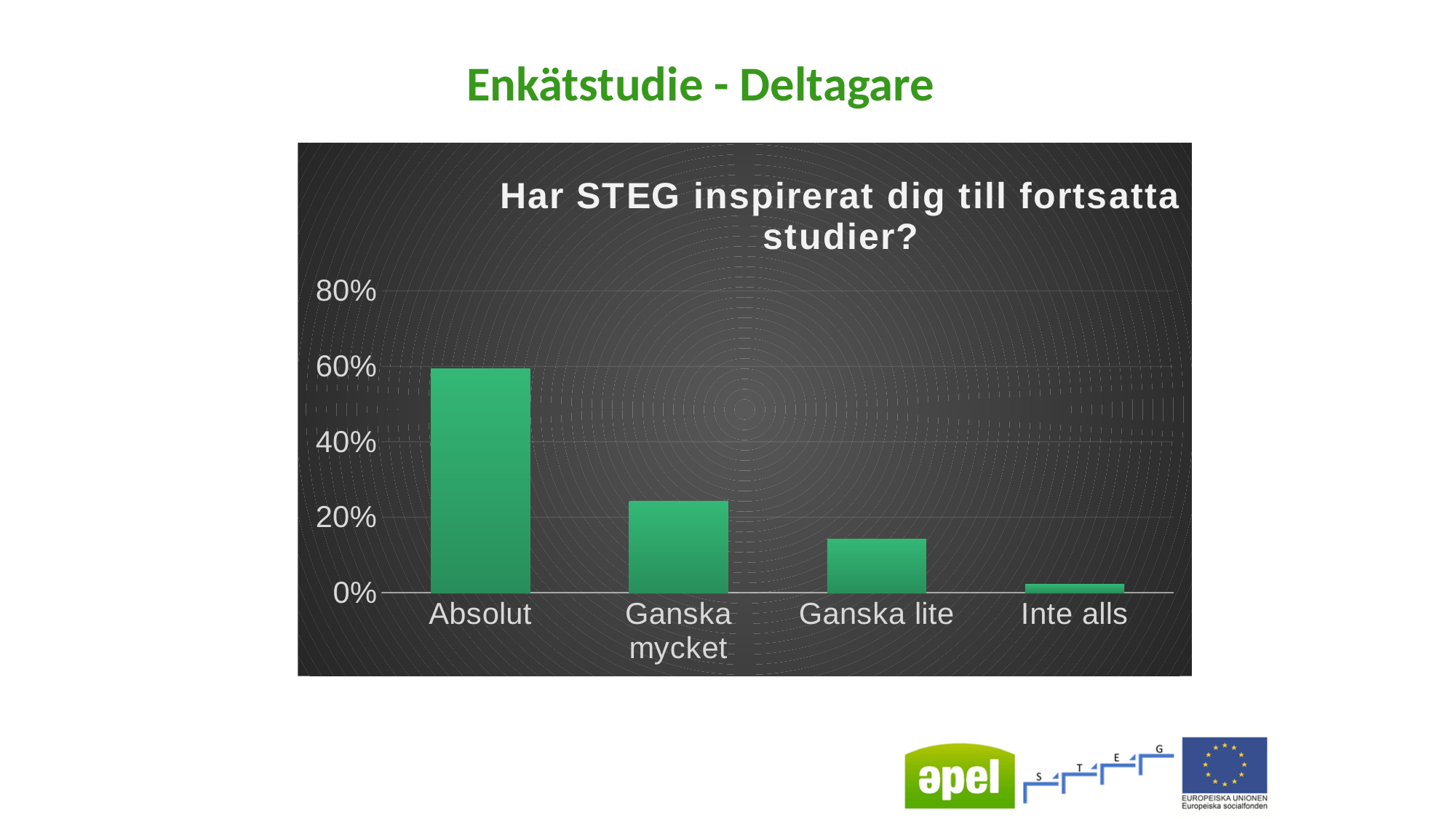
Is the value for Inte alls greater or less than 20%? less What is the title of the chart? Har STEG inspirerat dig till fortsatta studier? Is the value for Ganska mycket greater or less than 40%? less Do the values rise or fall from left to right along the x axis? fall What kind of chart is shown on the slide? bar chart Is the value for Absolut greater or less than 40%? greater Which is larger, the value for Ganska mycket or the value for Ganska lite? Ganska mycket Which category has the highest value? Absolut What is the highest value shown on the vertical axis? 80% How many categories are shown on the x axis of the chart? 4 Which category has the lowest value? Inte alls